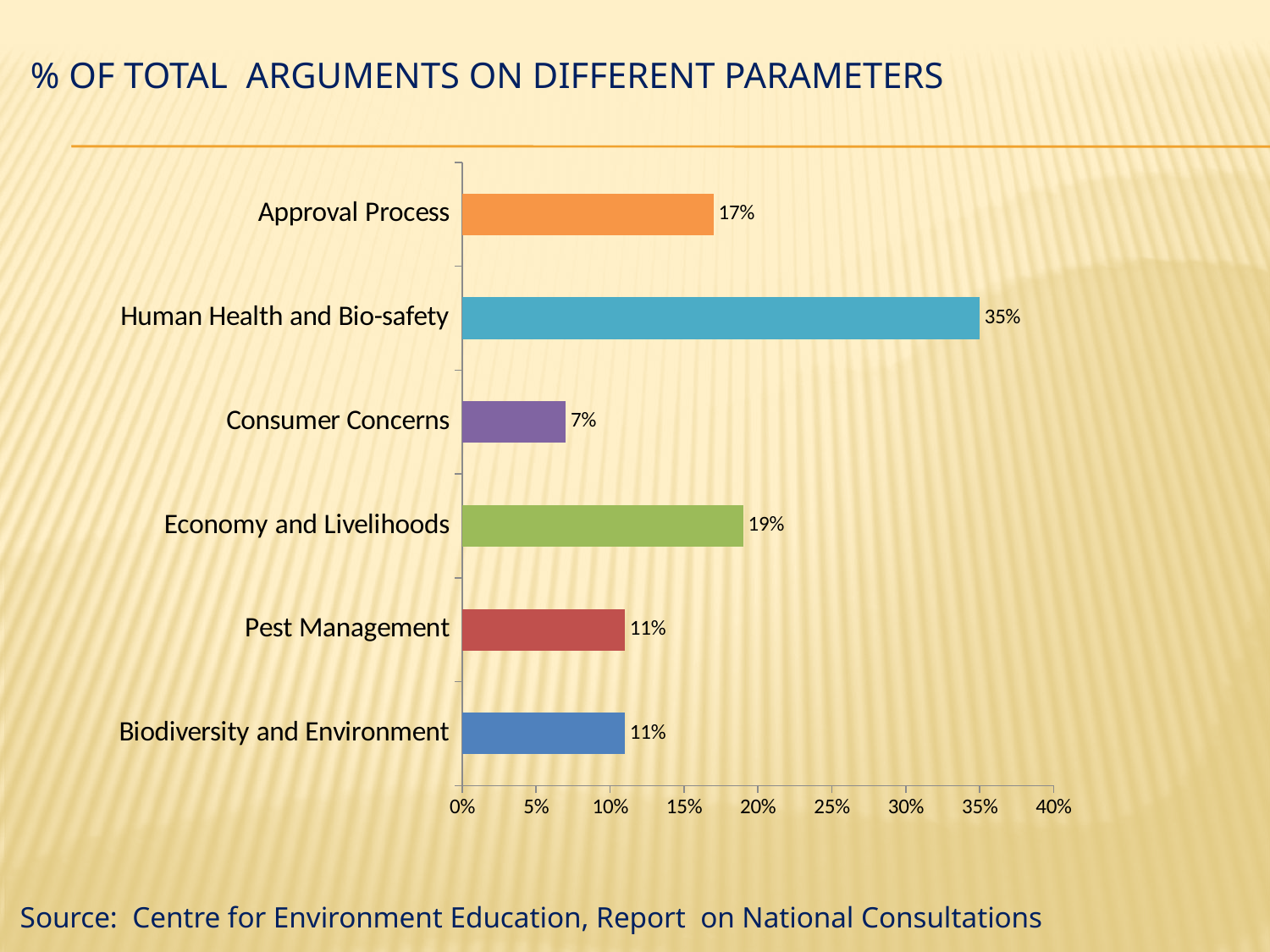
Which parameter has the lowest percentage of total arguments? Consumer Concerns Which parameter has the highest percentage of total arguments? Human Health and Bio-safety What percentage of total arguments is shown for Human Health and Bio-safety? 35% What is the value for Consumer Concerns? 7% Which is larger, the value for Approval Process or the value for Economy and Livelihoods? Economy and Livelihoods What is the value for Approval Process? 17% Is the value for Pest Management greater or less than 15%? less What is the difference between the values for Human Health and Bio-safety and Economy and Livelihoods? 16% What kind of chart is shown on the slide? Bar chart What is the value for Economy and Livelihoods? 19% How many parameters are shown in the chart? 6 What is the title of the chart on the slide? % of Total Arguments on Different Parameters